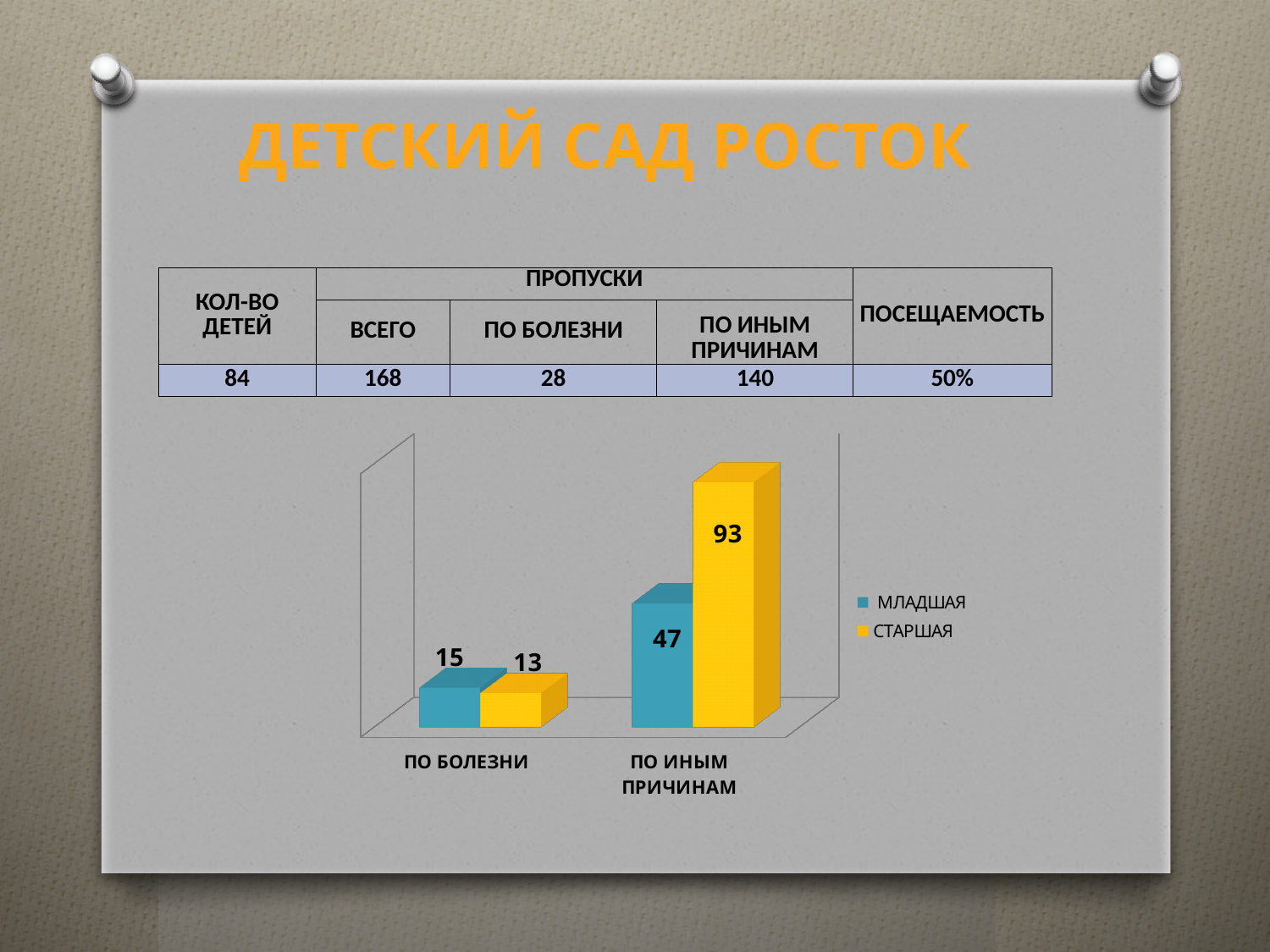
What is the value for СТАРШАЯ in the ПО БОЛЕЗНИ category? 13 How many series does the chart legend list? 2 What is the value for МЛАДШАЯ in the ПО БОЛЕЗНИ category? 15 Which is larger in the ПО БОЛЕЗНИ category: МЛАДШАЯ or СТАРШАЯ? МЛАДШАЯ What kind of chart is shown on the slide? Bar chart Which colour represents the СТАРШАЯ series in the chart? Yellow What is the difference between the СТАРШАЯ and МЛАДШАЯ values in the ПО ИНЫМ ПРИЧИНАМ category? 46 What is the value for СТАРШАЯ in the ПО ИНЫМ ПРИЧИНАМ category? 93 Which bar in the chart has the highest value? СТАРШАЯ, ПО ИНЫМ ПРИЧИНАМ Which bar in the chart has the lowest value? СТАРШАЯ, ПО БОЛЕЗНИ How many categories are shown on the x axis of the chart? 2 What is the value for МЛАДШАЯ in the ПО ИНЫМ ПРИЧИНАМ category? 47